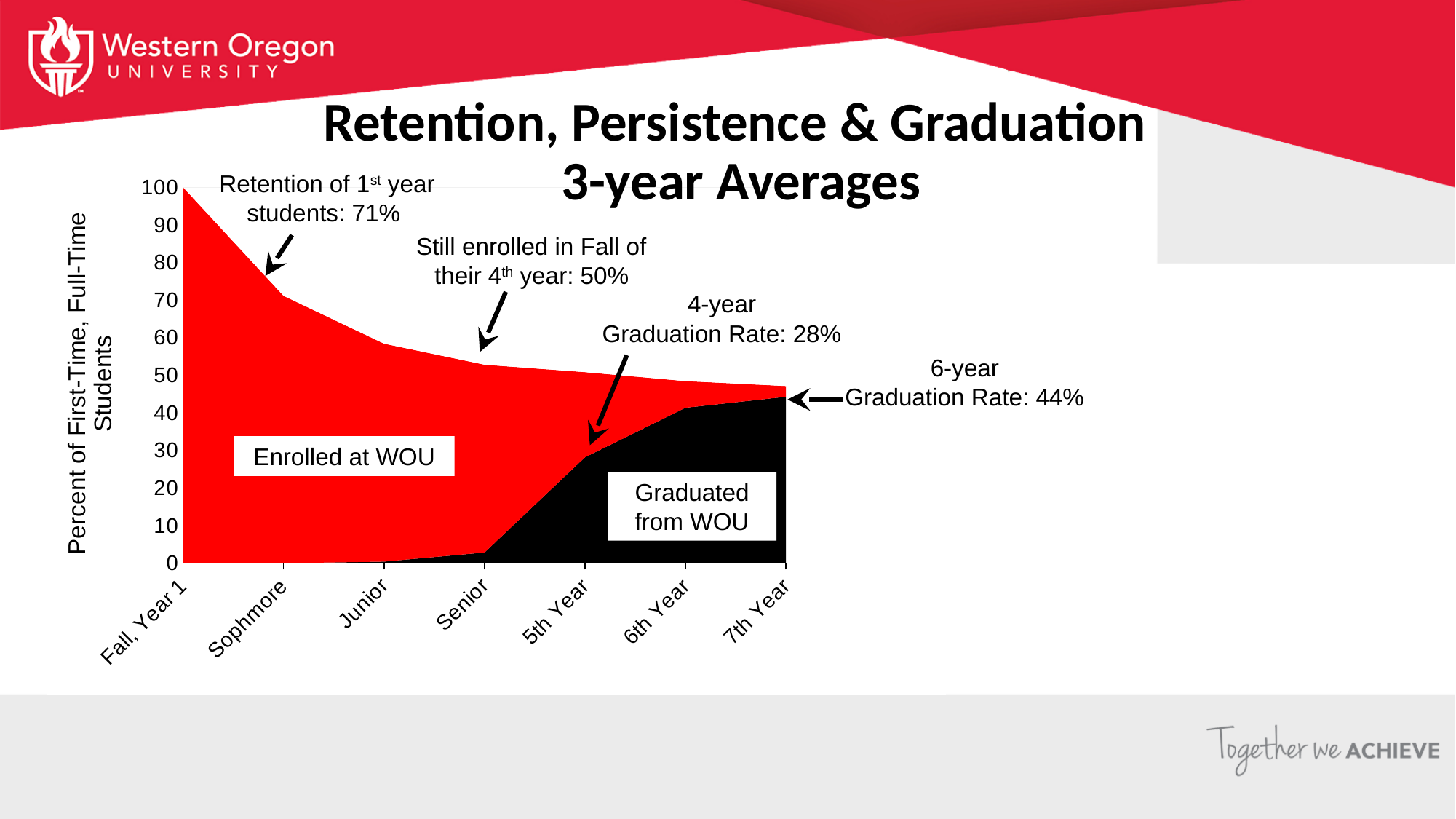
What is the label on the y axis of the chart? Percent of First-Time, Full-Time Students According to the chart annotation, what is the retention rate of 1st year students? 71% What is the 6-year graduation rate shown on the chart? 44% What is the 4-year graduation rate shown on the chart? 28% By how many percentage points does the 6-year graduation rate exceed the 4-year graduation rate? 16 percentage points Is the value of the Graduated from WOU area at 6th Year greater or less than 30? greater Does the total percentage of students (enrolled plus graduated) rise or fall from Fall, Year 1 to 7th Year? Fall What is the difference between the retention rate of 1st year students (71%) and the share still enrolled in Fall of their 4th year (50%)? 21 percentage points What kind of chart is shown on the slide? Area chart How many categories are shown along the x axis of the chart? 7 What percentage of students are still enrolled in Fall of their 4th year, according to the chart? 50% Which is larger, the 4-year graduation rate or the 6-year graduation rate? 6-year graduation rate